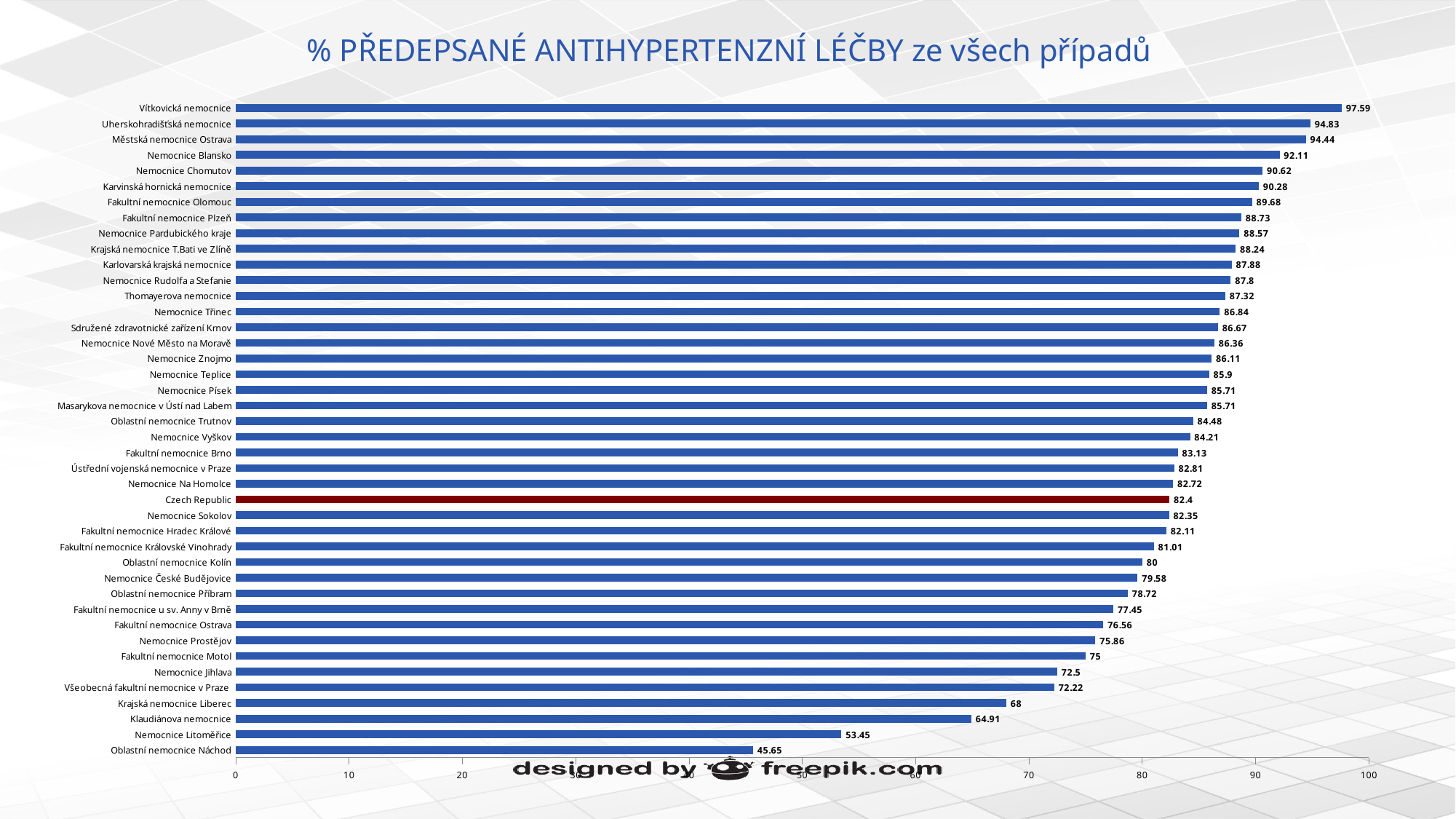
Which bar is shown in a different colour (dark red) from the others? Czech Republic What is the value for Czech Republic? 82.4 Which category has the lowest value? Oblastní nemocnice Náchod Which category has the highest value? Vítkovická nemocnice What is the value for Fakultní nemocnice Motol? 75 What kind of chart is shown on the slide? bar chart How many categories are shown in the chart? 42 Which is larger, the value for Nemocnice Jihlava or the value for Fakultní nemocnice Ostrava? Fakultní nemocnice Ostrava Is the value for Nemocnice Blansko greater or less than 90? greater What is the difference between the values for Krajská nemocnice Liberec and Klaudiánova nemocnice? 3.09 What is the difference between the values for Vítkovická nemocnice and Oblastní nemocnice Náchod? 51.94 What is the value for Nemocnice Litoměřice? 53.45